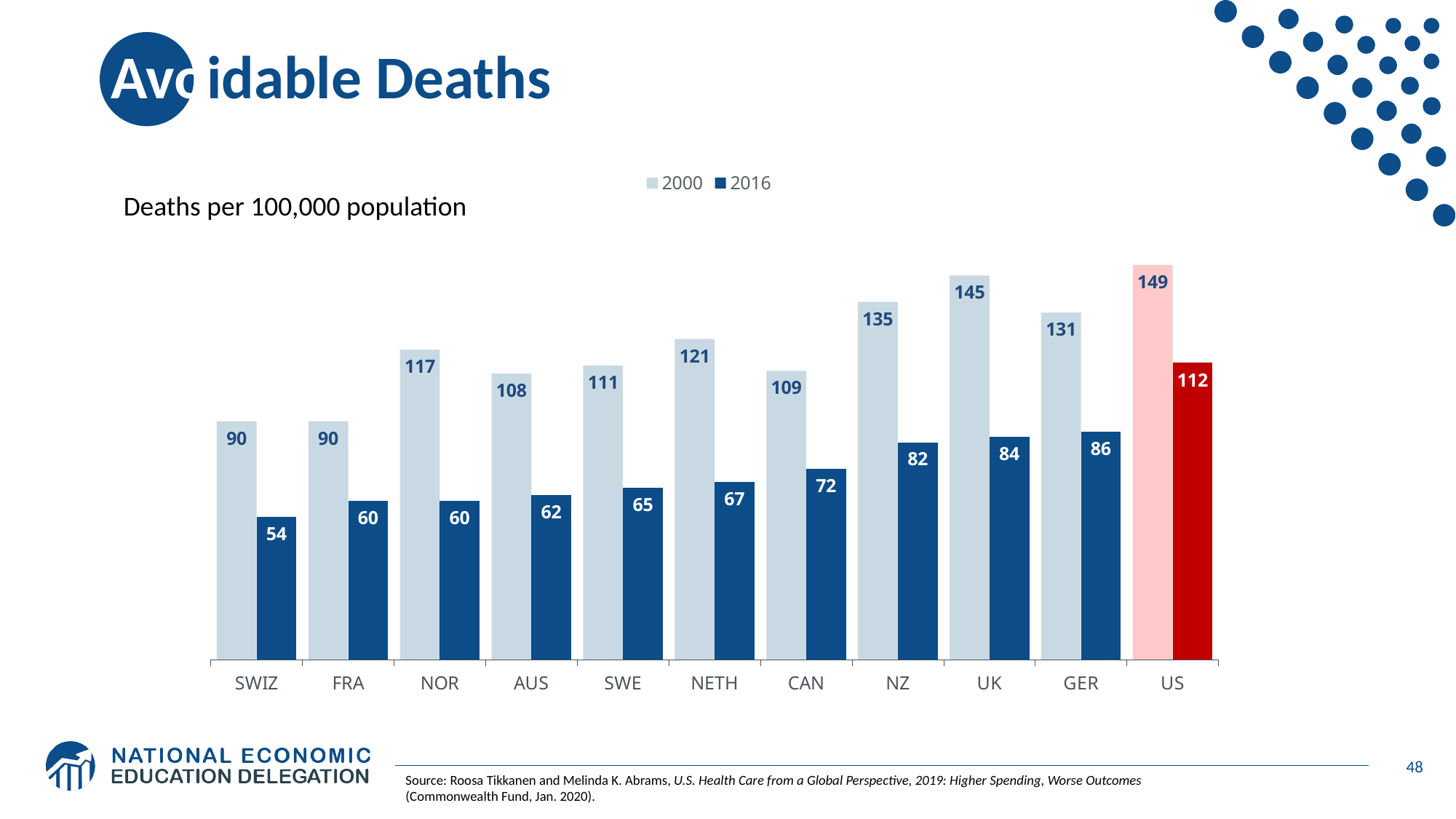
What was the value for the Netherlands (NETH) in 2016? 67 What was the value for the US in 2016? 112 What kind of chart is shown on the slide? Bar chart What is the difference between the 2000 and 2016 values for the UK? 61 What was the value for Switzerland (SWIZ) in 2000? 90 How many countries are shown on the x axis? 11 What unit is the chart measured in, according to the label above the chart? Deaths per 100,000 population Which country had the highest value in 2000? US Which is larger, the 2016 value for Germany (GER) or the 2016 value for Canada (CAN)? GER Which country had the lowest value in 2016? SWIZ How many series does the legend list? 2 What is the difference between the 2000 value for the US and the 2000 value for the UK? 4